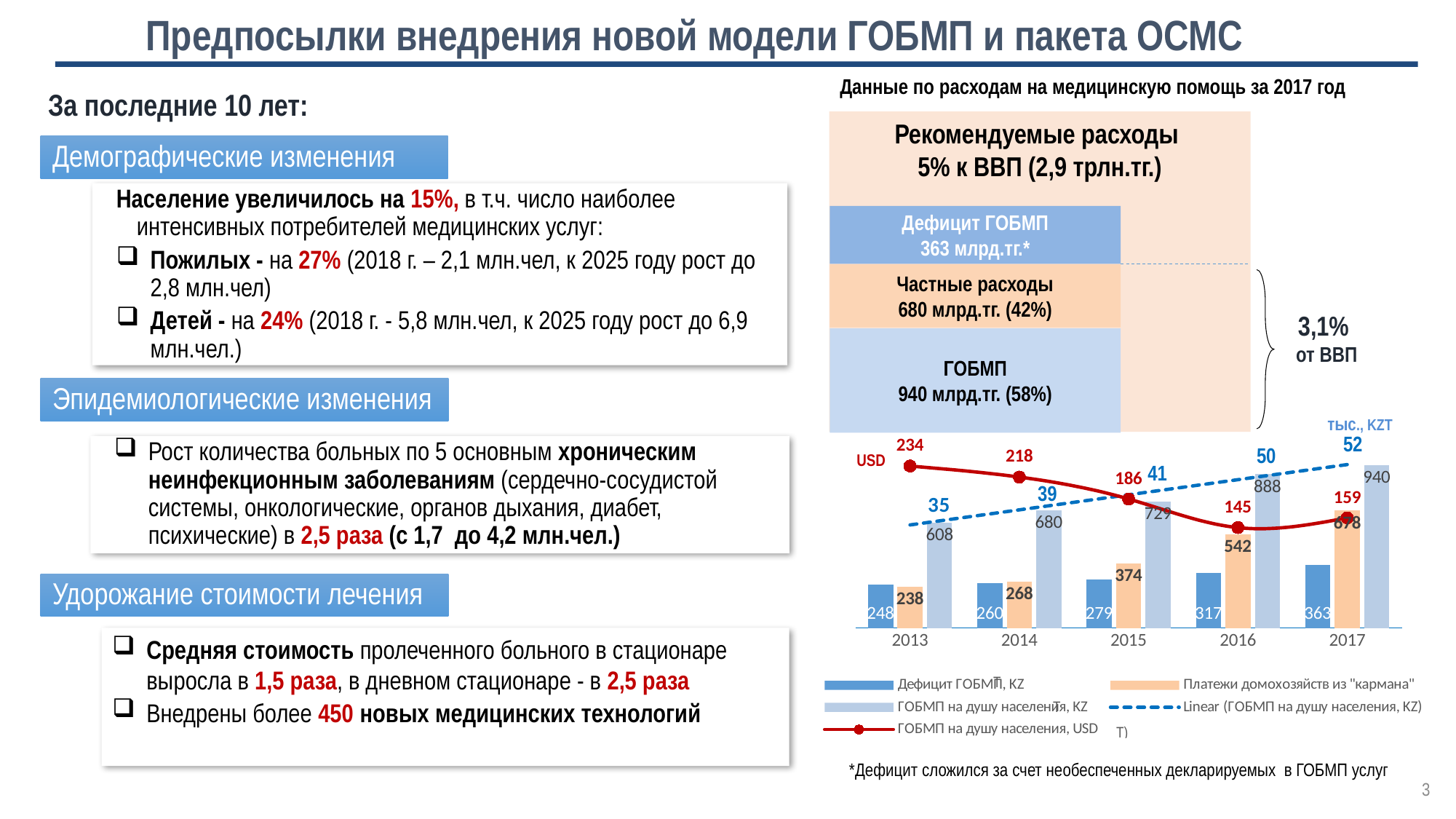
What colour are the bars for 'Платежи домохозяйств из "кармана"'? orange What is the value of 'ГОБМП на душу населения, USD' for 2015? 186 What is the value of the 'Дефицит ГОБМП, KZ' series for 2017? 363 Does 'ГОБМП на душу населения, KZ' rise or fall from 2013 to 2017? rise Which is larger in 2015: 'Дефицит ГОБМП, KZ' or 'Платежи домохозяйств из "кармана"'? Платежи домохозяйств из "кармана" By how much did 'Дефицит ГОБМП, KZ' change from 2013 to 2017? 115 How many years are shown on the x axis of the chart? 5 How many series does the chart legend list? 5 What is the value of 'ГОБМП на душу населения, KZ' for 2013? 608 In which year is 'ГОБМП на душу населения, USD' lowest? 2016 What is the value of 'Платежи домохозяйств из "кармана"' for 2016? 542 In which year is 'ГОБМП на душу населения, KZ' highest? 2017